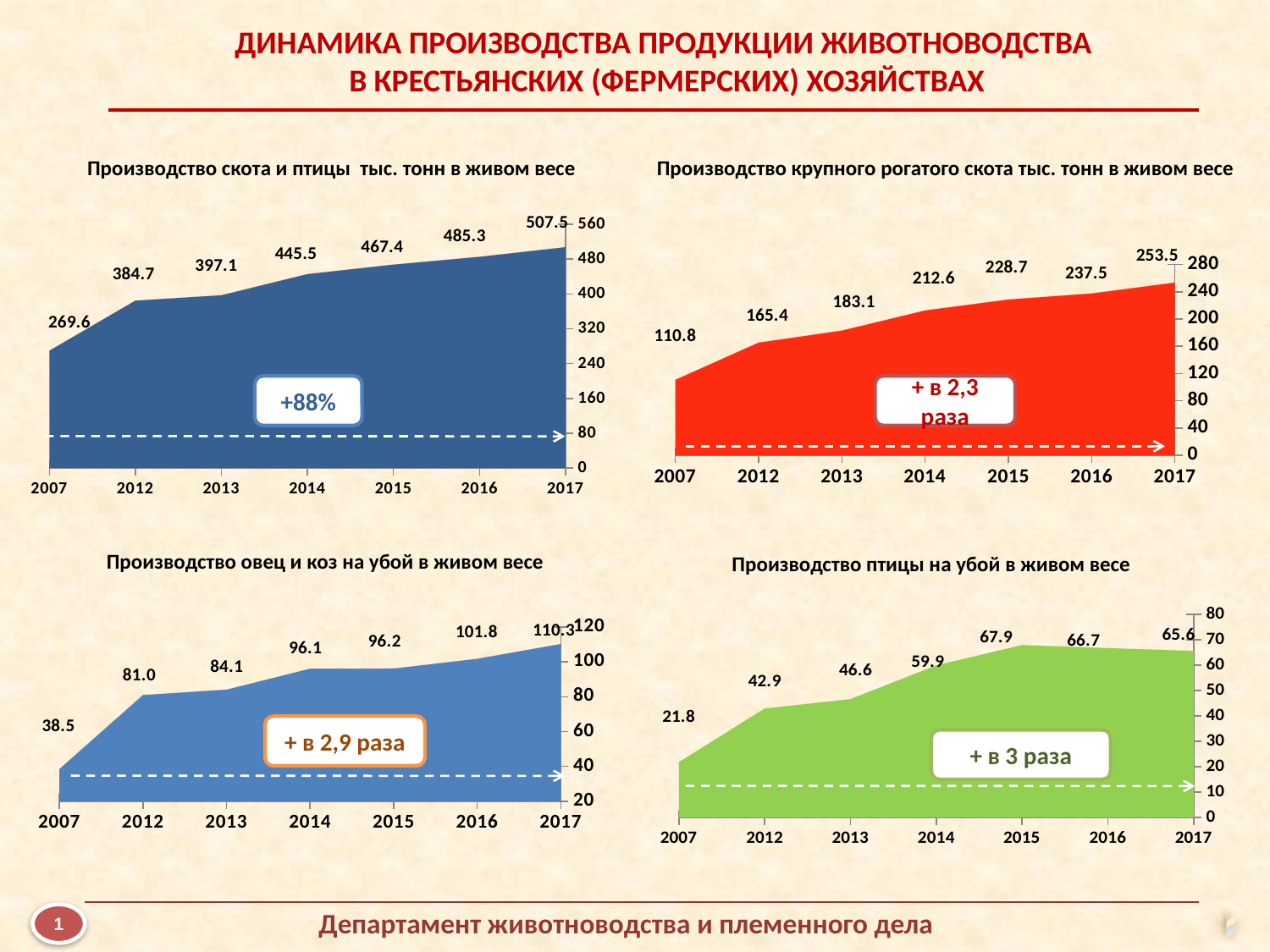
In the bottom-right chart (Производство птицы на убой), what is the difference between the 2015 and 2007 values? 46.1 In the top-right chart (Производство крупного рогатого скота), what is the value for 2014? 212.6 How many years are plotted in the top-left chart (Производство скота и птицы)? 7 In the top-right chart (Производство крупного рогатого скота), what is the difference between the 2017 and 2007 values? 142.7 In the top-left chart (Производство скота и птицы), what is the value for 2017? 507.5 In the top-left chart (Производство скота и птицы), do the values rise or fall from 2007 to 2017? rise What type of chart is the top-right chart (Производство крупного рогатого скота)? area chart In the bottom-left chart (Производство овец и коз), what is the value for 2016? 101.8 In the bottom-right chart (Производство птицы на убой), which year has the highest value? 2015 In the top-left chart (Производство скота и птицы), what is the value for 2007? 269.6 In the bottom-right chart (Производство птицы на убой), is the value for 2016 larger or smaller than the value for 2017? larger In the bottom-left chart (Производство овец и коз), which year has the lowest value? 2007